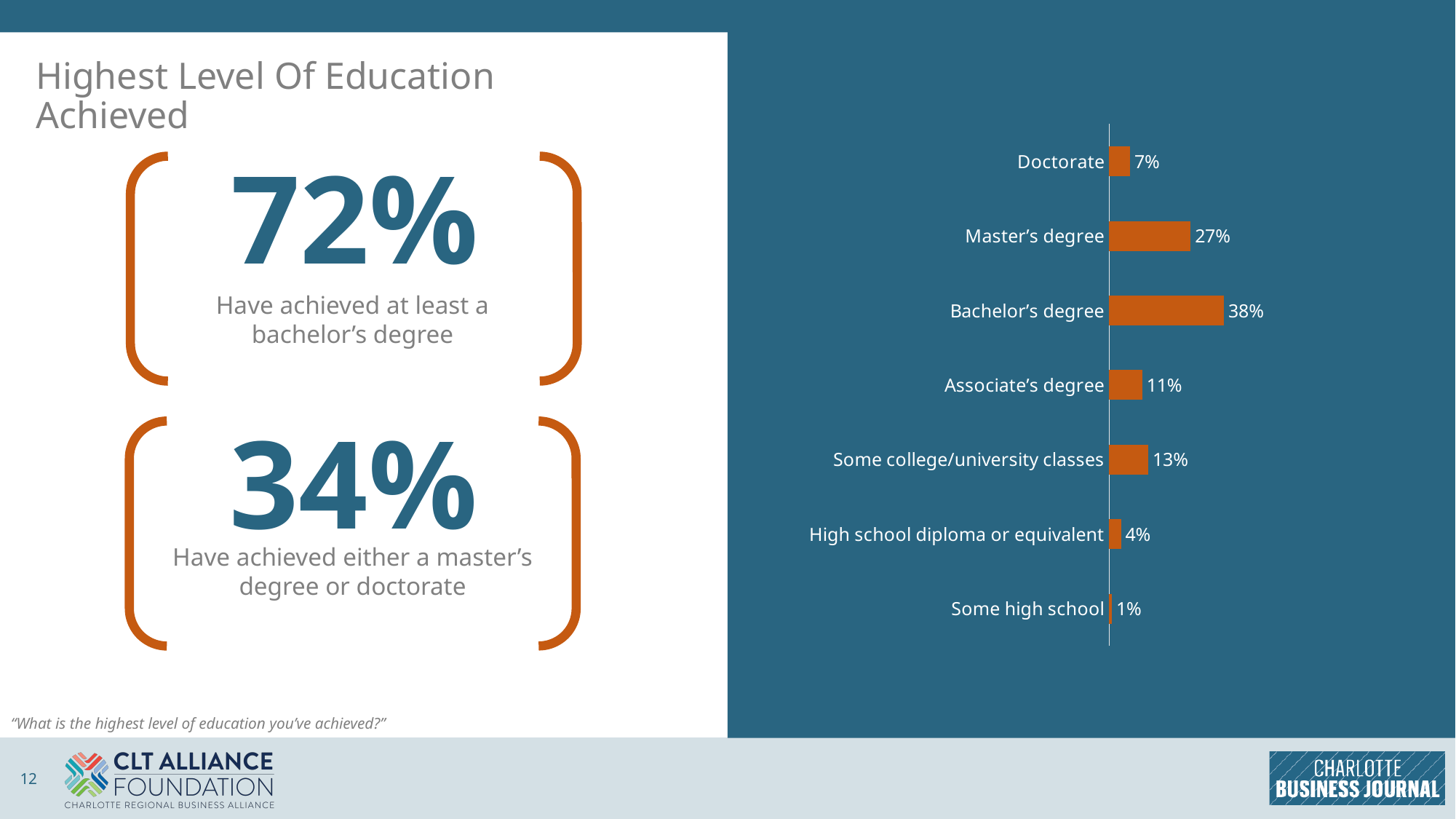
What colour are the bars in the chart? Orange What is the value shown for Some college/university classes? 13% Which education level has the lowest percentage in the chart? Some high school What is the difference in percentage points between Associate's degree and High school diploma or equivalent? 7 What kind of chart is used to show the highest level of education achieved? Bar chart Which education level has the highest percentage in the chart? Bachelor's degree How many education levels are shown in the chart? 7 What is the combined percentage for Master's degree and Doctorate? 34% Which is larger, the value for Associate's degree or the value for Doctorate? Associate's degree What is the difference in percentage points between Bachelor's degree and Master's degree? 11 What percentage of respondents have a Bachelor's degree as their highest level of education? 38% What percentage of respondents have a Doctorate as their highest level of education? 7%